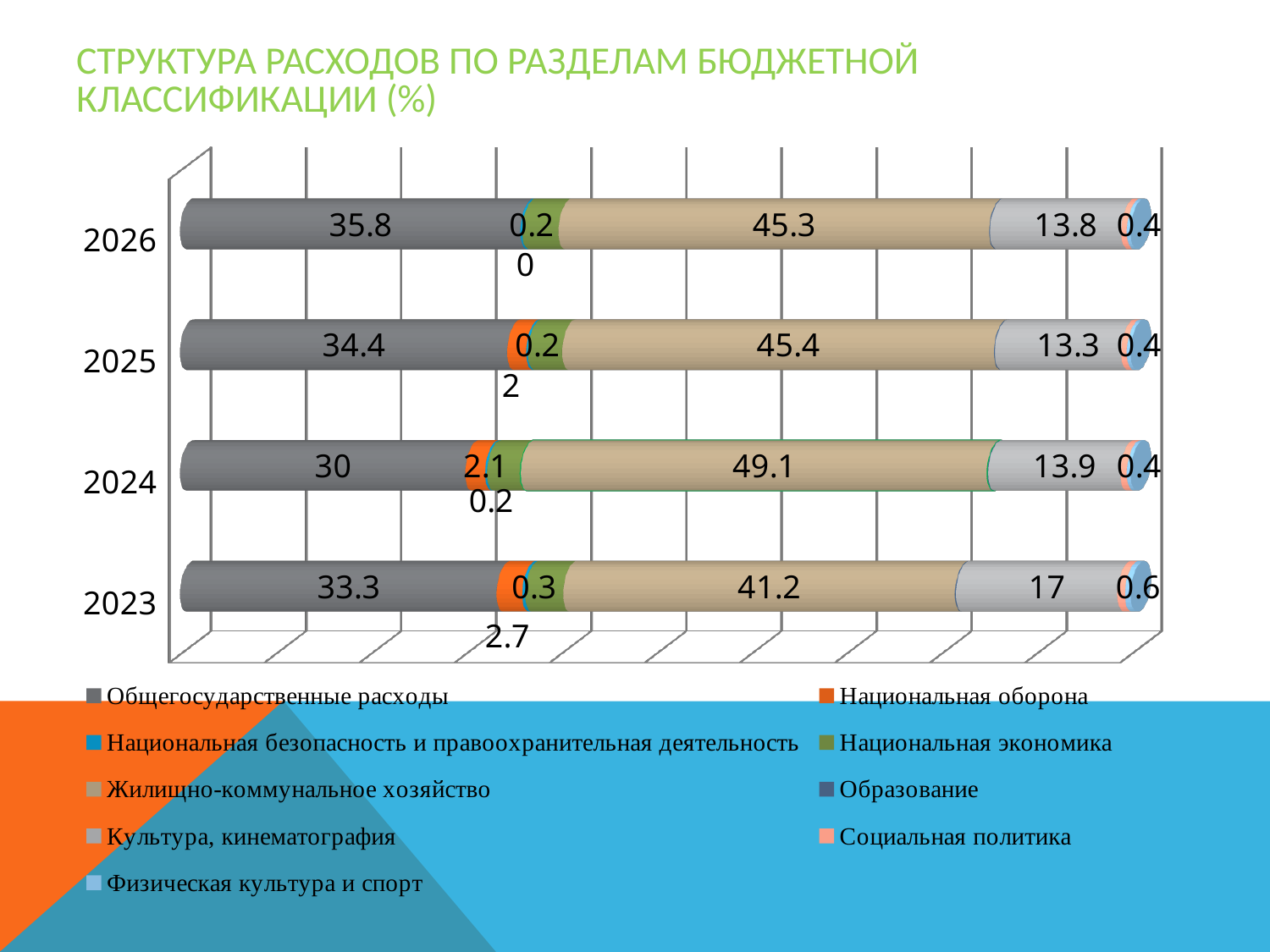
What is the value for Общегосударственные расходы in 2024? 30 What is the largest labeled value in the 2024 bar? 49.1 In which year is the value for Общегосударственные расходы the highest? 2026 How many years (categories) are shown on the vertical axis of the chart? 4 What is the difference between the Общегосударственные расходы values for 2026 and 2025? 1.4 What kind of chart is shown on the slide? Stacked bar chart What is the value for Общегосударственные расходы in 2026? 35.8 In which year is the value for Общегосударственные расходы the lowest? 2024 What is the title of the chart on the slide? СТРУКТУРА РАСХОДОВ ПО РАЗДЕЛАМ БЮДЖЕТНОЙ КЛАССИФИКАЦИИ (%) What is the largest labeled value in the 2023 bar? 41.2 How many series does the chart legend list? 9 Which year has the larger value for Общегосударственные расходы, 2023 or 2024? 2023